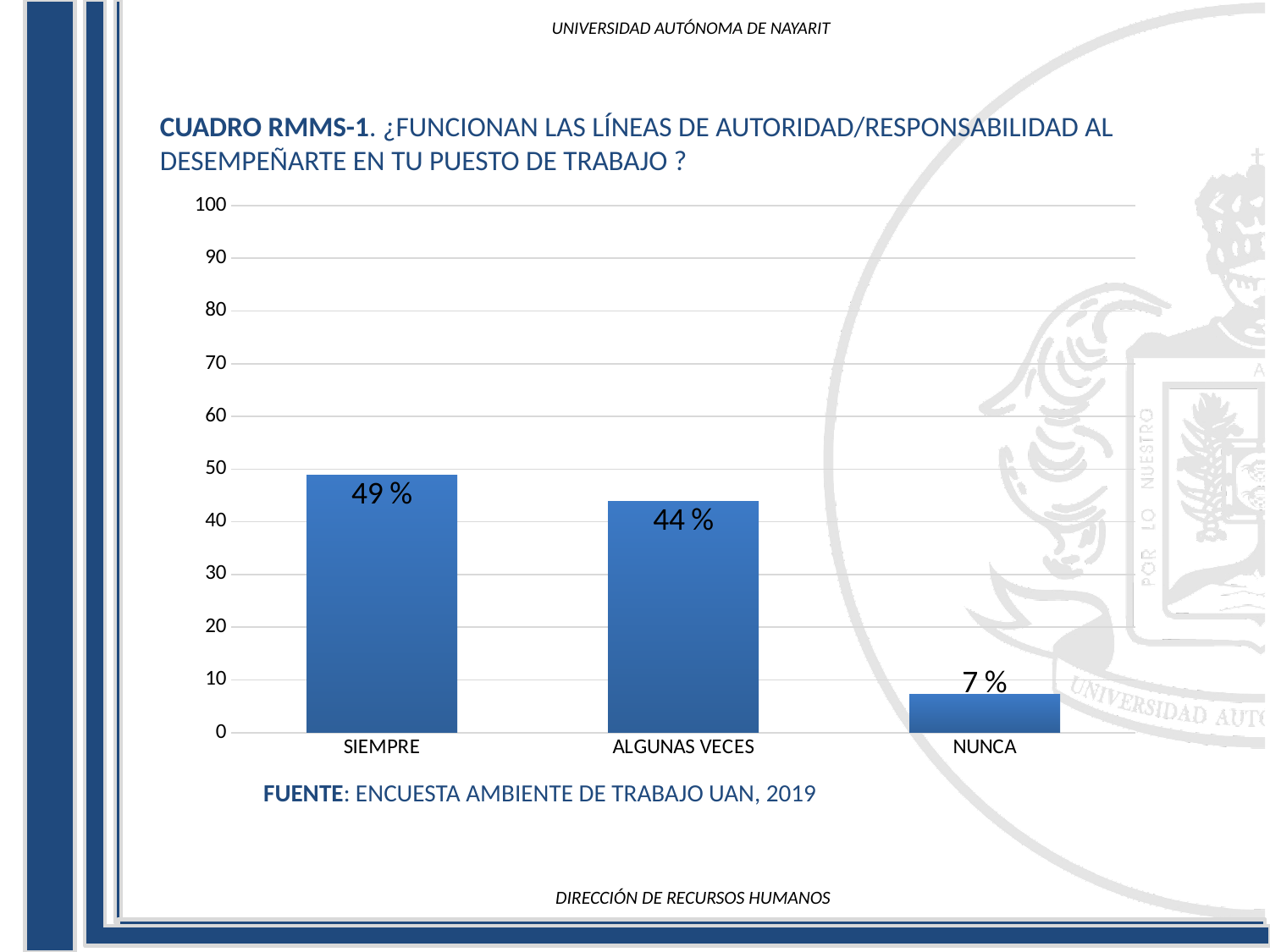
What source is cited below the chart? ENCUESTA AMBIENTE DE TRABAJO UAN, 2019 Is the value for ALGUNAS VECES greater or less than 50? less What is the difference between the values for SIEMPRE and ALGUNAS VECES? 5 % How many categories are shown on the x axis? 3 What is the difference between the values for ALGUNAS VECES and NUNCA? 37 % What kind of chart is shown on the slide? bar chart Which is larger, the value for SIEMPRE or the value for NUNCA? SIEMPRE What is the value for SIEMPRE? 49 % Which category has the lowest value? NUNCA What is the value for ALGUNAS VECES? 44 % Which category has the highest value? SIEMPRE What is the value for NUNCA? 7 %